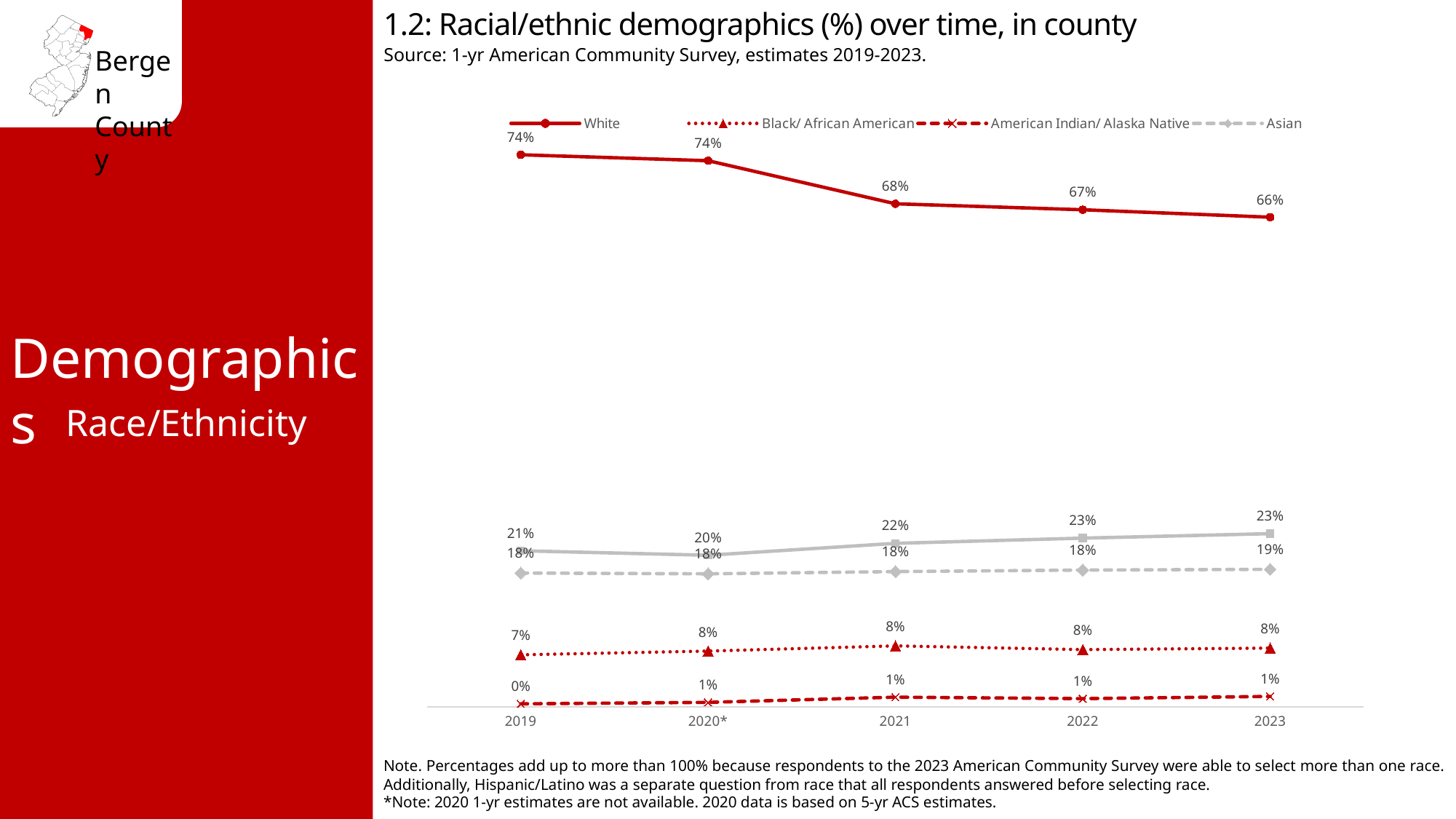
What was the White percentage in 2023? 66% By how many percentage points did the White share fall from 2019 to 2023? 8 What was the Asian percentage in 2023? 19% Does the White line rise or fall from 2019 to 2023? Fall What was the American Indian/ Alaska Native percentage in 2019? 0% Which was larger in 2021, the Asian percentage or the Black/ African American percentage? Asian In which year was the White percentage lowest? 2023 What is the title of the chart? 1.2: Racial/ethnic demographics (%) over time, in county How many years are shown on the x axis? 5 What was the White percentage in 2019? 74% What was the Black/ African American percentage in 2019? 7% What kind of chart is this? Line chart